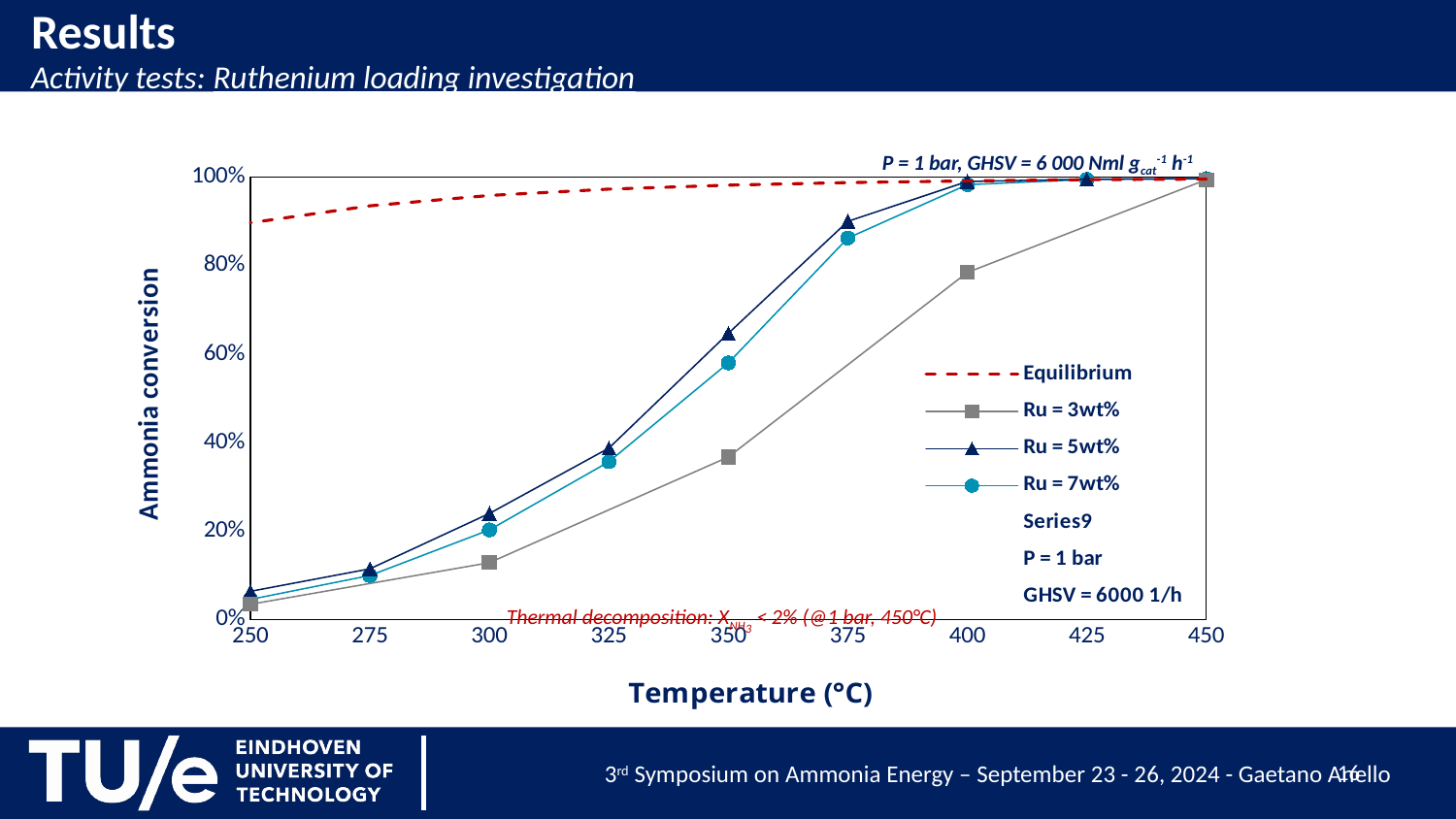
At 350 °C, which has the higher ammonia conversion, Ru = 3wt% or Ru = 5wt%? Ru = 5wt% What is the title of the x axis? Temperature (°C) Is the ammonia conversion for Ru = 5wt% at 300 °C greater or less than 20%? greater Is the ammonia conversion for Ru = 3wt% at 350 °C greater or less than 40%? less How many temperature points are marked on the x axis? 9 Does the ammonia conversion for Ru = 3wt% rise or fall as temperature increases? rise What kind of chart is shown on the slide? line chart Is the ammonia conversion for Ru = 7wt% at 375 °C greater or less than 80%? greater What is the title of the y axis? Ammonia conversion Among the Ru loading series, which has the lowest ammonia conversion at 375 °C? Ru = 3wt% How many Ru loading series (Ru = ...wt%) are plotted? 3